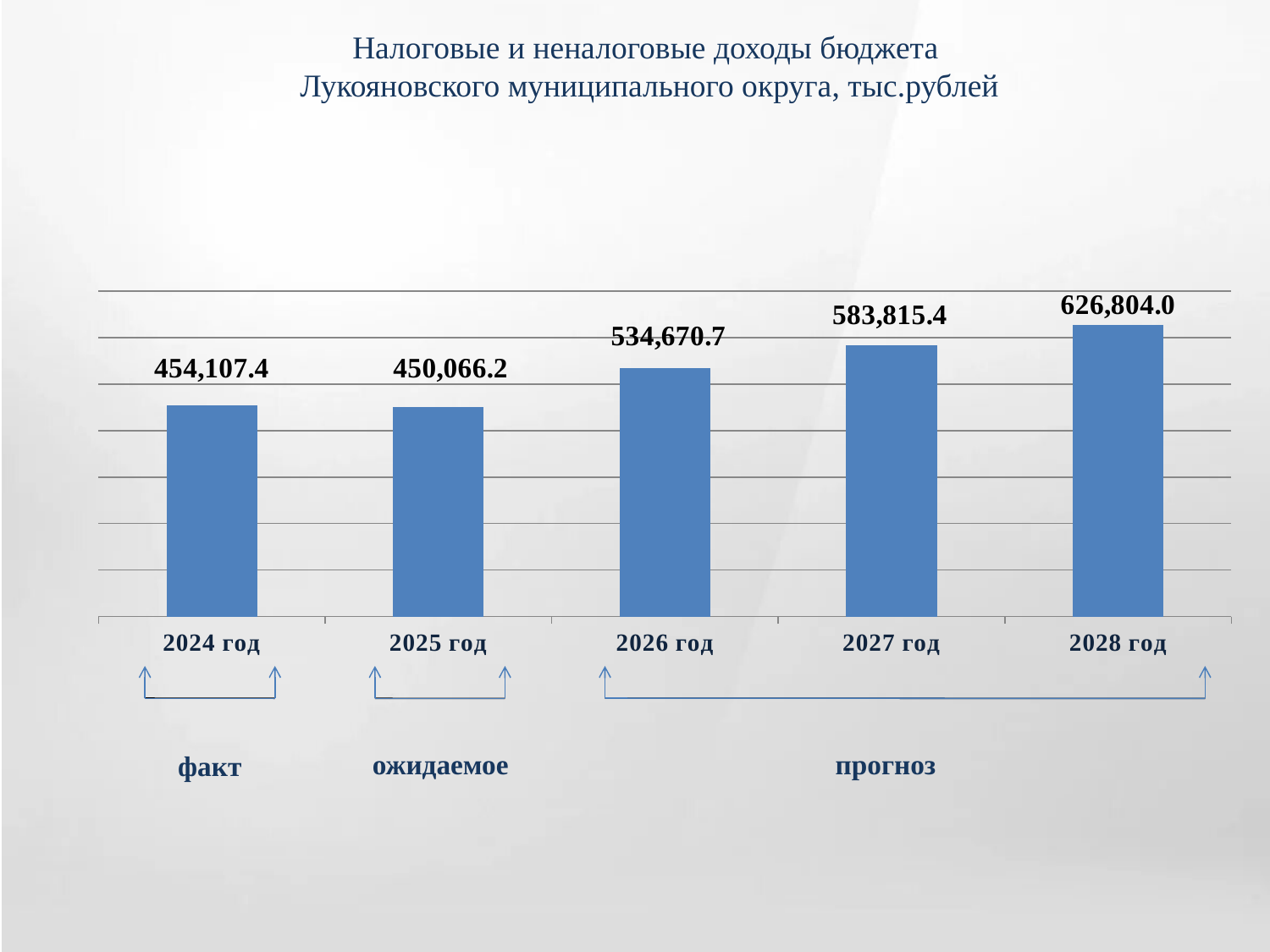
Which years are labelled as прогноз (forecast) below the chart? 2026 год, 2027 год, 2028 год What is the difference between the values for 2028 год and 2027 год? 42,988.6 What kind of chart is shown on the slide? bar chart What is the difference between the values for 2026 год and 2025 год? 84,604.5 How many years are shown on the chart? 5 Which is larger, the value for 2024 год or the value for 2025 год? 2024 год Which year has the highest value? 2028 год Do the values rise or fall from 2025 год to 2028 год? rise Which year has the lowest value? 2025 год What is the value for 2028 год? 626,804.0 What is the value for 2026 год? 534,670.7 What is the value for 2024 год? 454,107.4